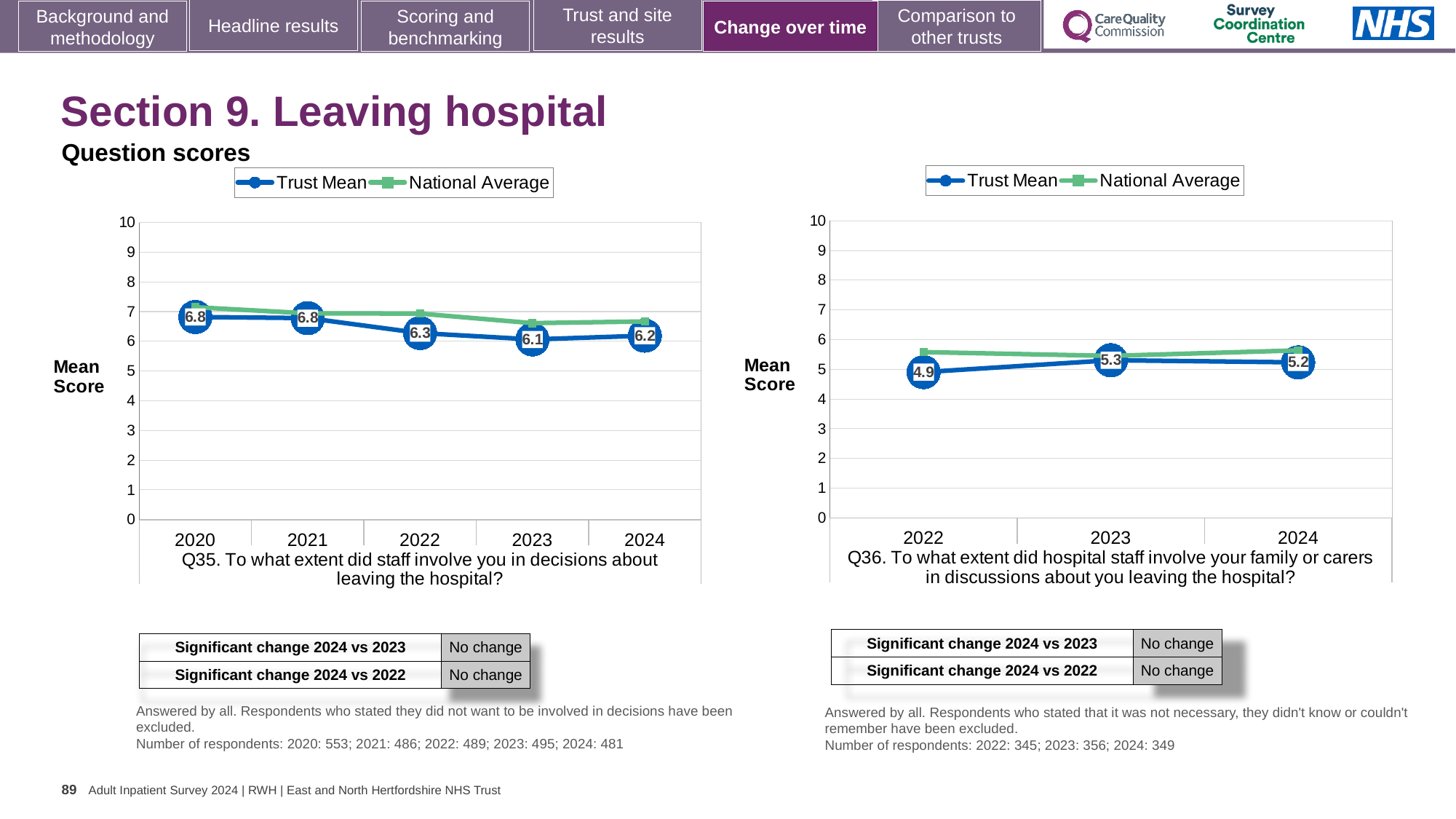
On the Q35 chart (left), how many years are shown on the x axis? 5 On the Q36 chart (right), what is the Trust Mean score for 2023? 5.3 On the Q36 chart (right), what is the Trust Mean score for 2022? 4.9 On the Q36 chart (right), which year has the highest Trust Mean score? 2023 On the Q36 chart (right), how many series does the legend list? 2 On the Q35 chart (left), what is the Trust Mean score for 2024? 6.2 On the Q35 chart (left), does the Trust Mean score generally rise or fall from 2020 to 2023? Fall On the Q35 chart (left), which year has the lowest Trust Mean score? 2023 On the Q35 chart (left), what is the Trust Mean score for 2022? 6.3 On the Q35 chart (left), what is the difference between the Trust Mean score in 2020 and in 2024? 0.6 On the Q36 chart (right), is the Trust Mean score for 2022 greater or less than 5? less What type of chart is used for the Q35 question scores on the left? Line chart